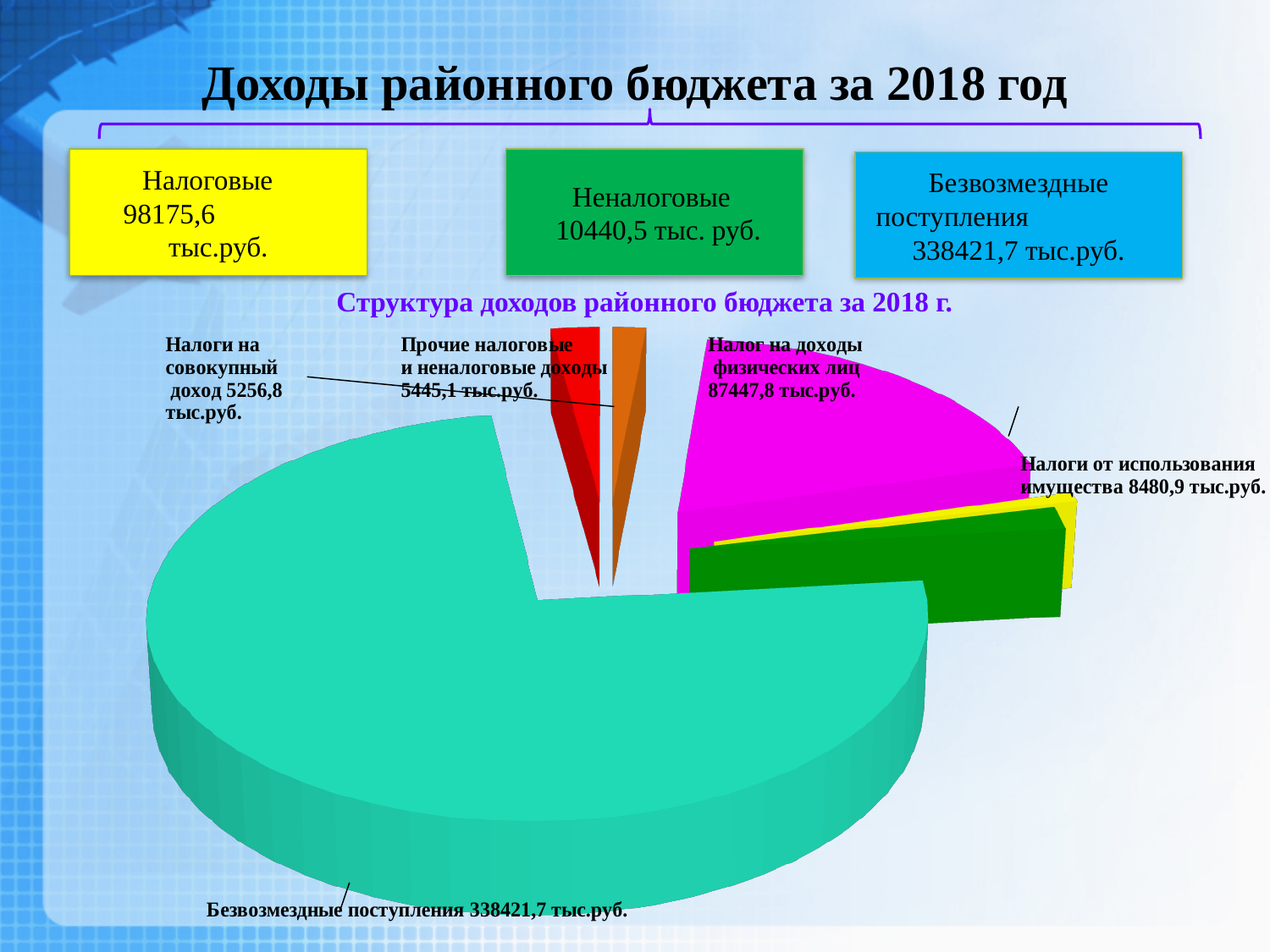
Which slice of the pie chart is the largest? Безвозмездные поступления Which is larger: "Налог на доходы физических лиц" or "Налоги от использования имущества"? Налог на доходы физических лиц What colour is the "Безвозмездные поступления" slice in the pie chart? turquoise (teal) What is the value of the "Налоги от использования имущества" slice? 8480,9 тыс.руб. What is the difference between "Налоги от использования имущества" and "Прочие налоговые и неналоговые доходы"? 3035,8 тыс.руб. How many slices does the pie chart have? 6 What is the value of the "Налог на доходы физических лиц" slice? 87447,8 тыс.руб. What is the value of the "Прочие налоговые и неналоговые доходы" slice? 5445,1 тыс.руб. What is the value of the "Безвозмездные поступления" slice in the pie chart? 338421,7 тыс.руб. What type of chart is shown under the heading "Структура доходов районного бюджета за 2018 г."? pie chart What is the difference between "Безвозмездные поступления" and "Налог на доходы физических лиц" in the pie chart? 250973,9 тыс.руб.